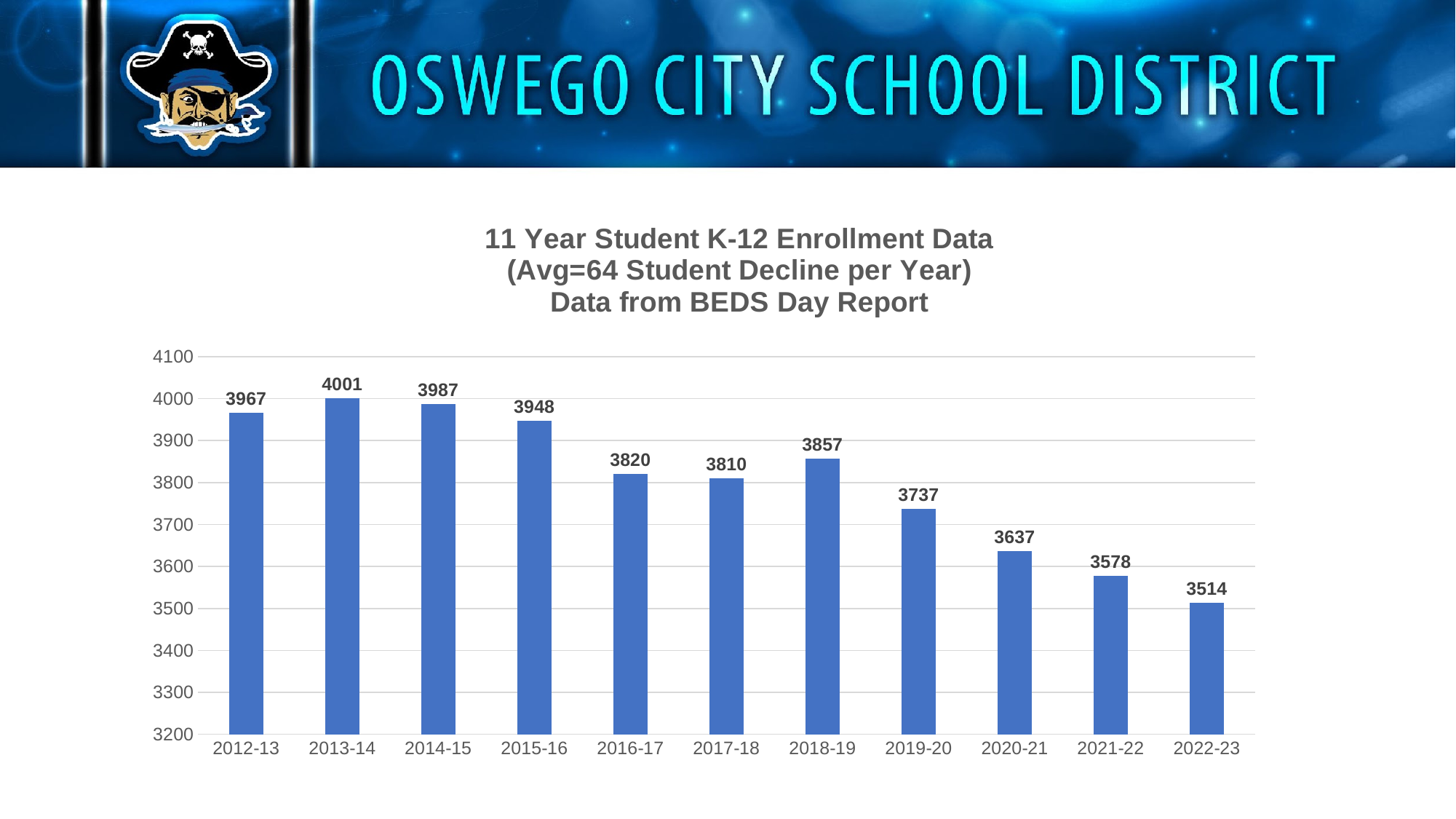
What is the difference in enrollment between 2013-14 and 2022-23? 487 Which year had higher enrollment, 2017-18 or 2018-19? 2018-19 What was the K-12 enrollment in 2018-19? 3857 What was the K-12 enrollment in 2022-23? 3514 What type of chart is shown on the slide? Bar chart Which school year had the lowest enrollment? 2022-23 What is the overall trend in enrollment from 2012-13 to 2022-23? Falling Is the enrollment for 2021-22 greater or less than 3600? less How many school years are shown on the chart? 11 What was the K-12 enrollment in 2012-13? 3967 What is the difference in enrollment between 2019-20 and 2020-21? 100 Which school year had the highest enrollment? 2013-14